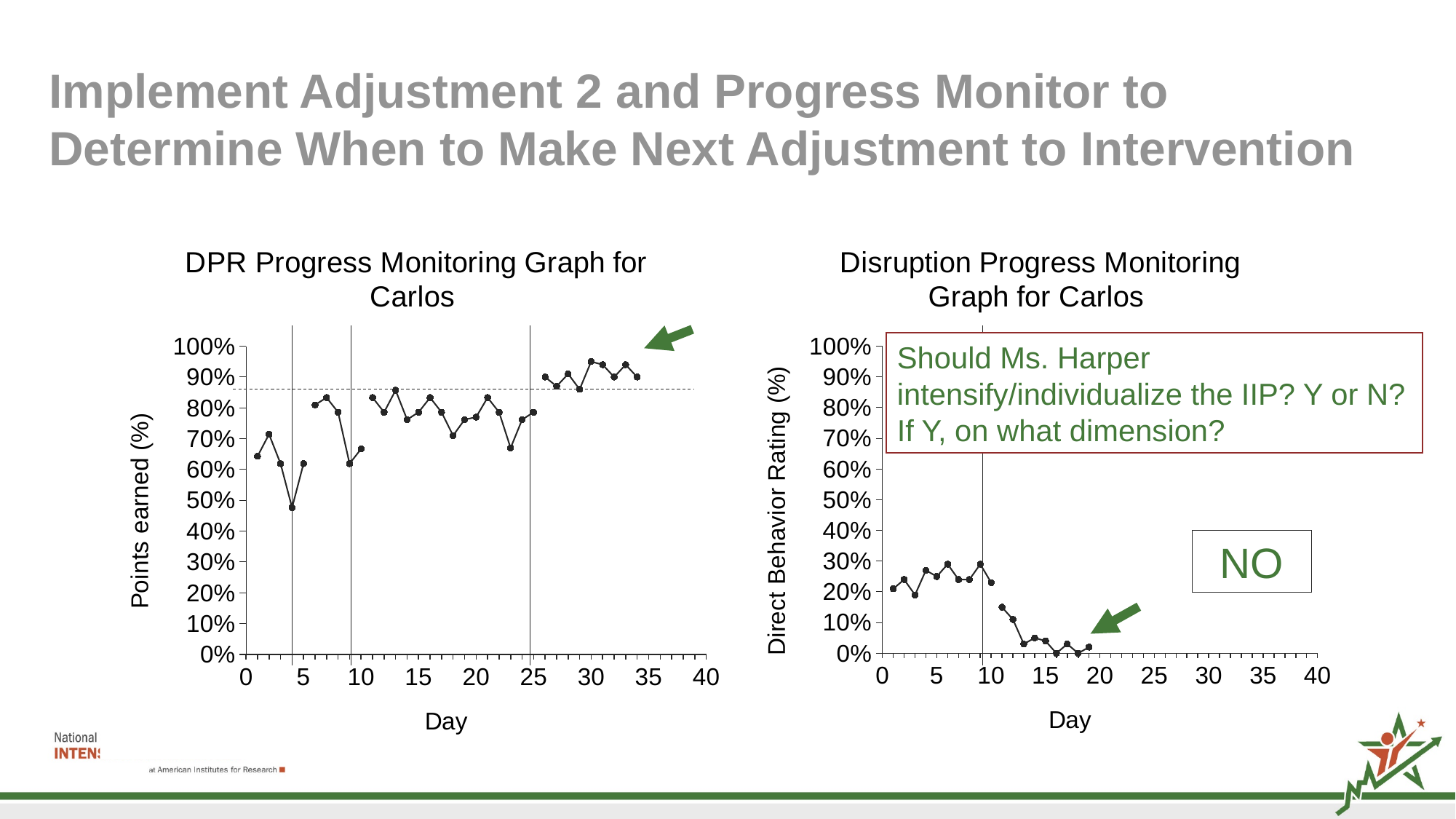
In the Disruption Progress Monitoring Graph for Carlos, do the values rise or fall after day 10? fall In the DPR Progress Monitoring Graph for Carlos, is the value for day 23 greater or less than 70%? less In the DPR Progress Monitoring Graph for Carlos, is the value for day 4 greater or less than 60%? less What type of chart is the Disruption Progress Monitoring Graph for Carlos? line chart What type of chart is the DPR Progress Monitoring Graph for Carlos? line chart In the Disruption Progress Monitoring Graph for Carlos, is the value for day 15 greater or less than 10%? less In the DPR Progress Monitoring Graph for Carlos, do the values after day 25 generally rise or fall compared with the values before day 10? rise In the Disruption Progress Monitoring Graph for Carlos, what is the label of the y-axis? Direct Behavior Rating (%) In the DPR Progress Monitoring Graph for Carlos, what is the label of the y-axis? Points earned (%)